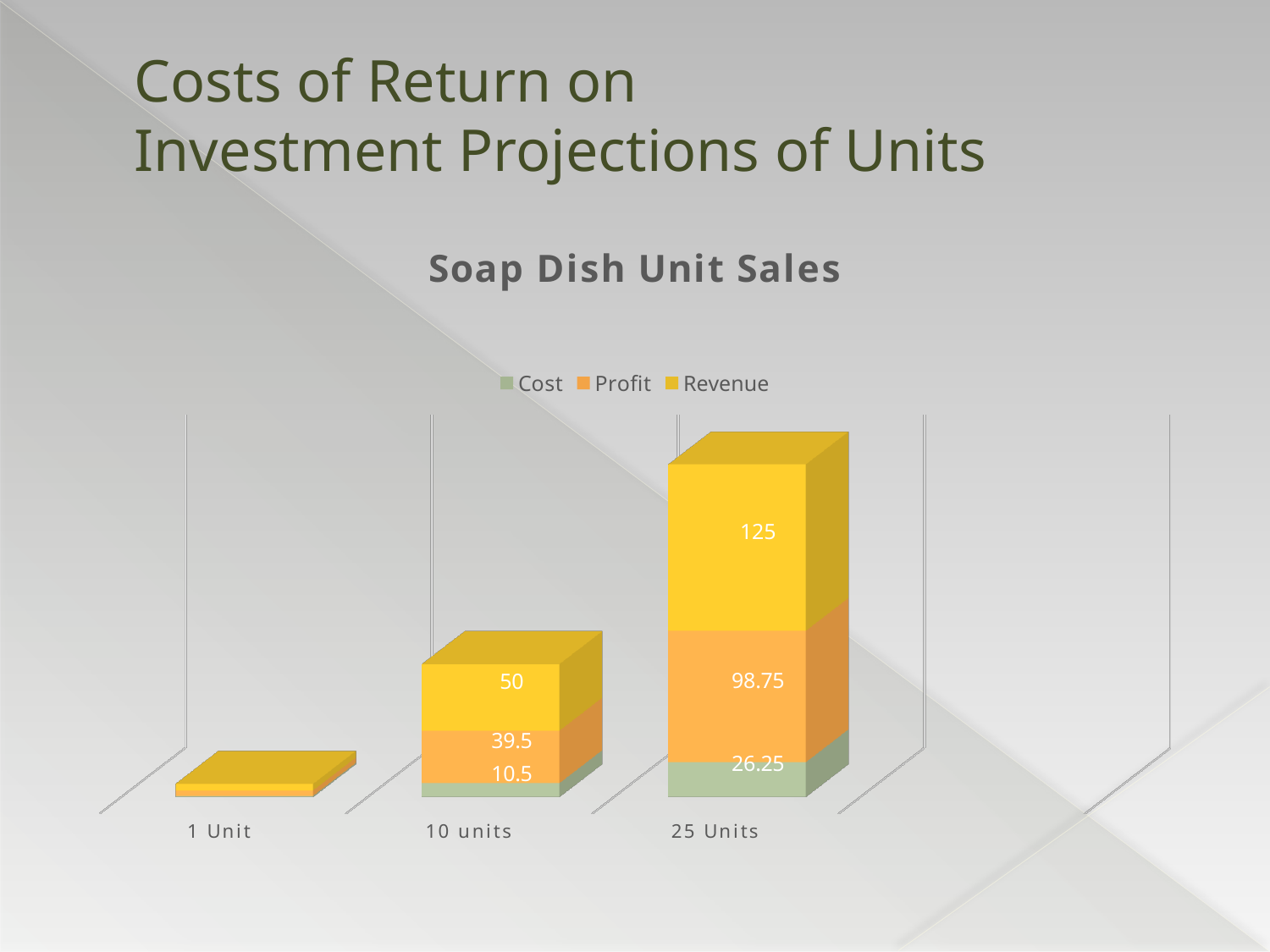
What is the title of the chart? Soap Dish Unit Sales How many categories are shown on the x axis? 3 What is the Cost value for 25 Units? 26.25 What is the Profit value for 10 units? 39.5 Which category has the highest Revenue? 25 Units What is the difference between the Revenue for 25 Units and the Revenue for 10 units? 75 How many series does the legend list? 3 What type of chart is shown on the slide? Stacked bar chart What is the Revenue value for 25 Units? 125 Which is larger, the Profit for 25 Units or the Profit for 10 units? 25 Units What is the total of the stacked bar for 25 Units? 250 What is the Cost value for 10 units? 10.5